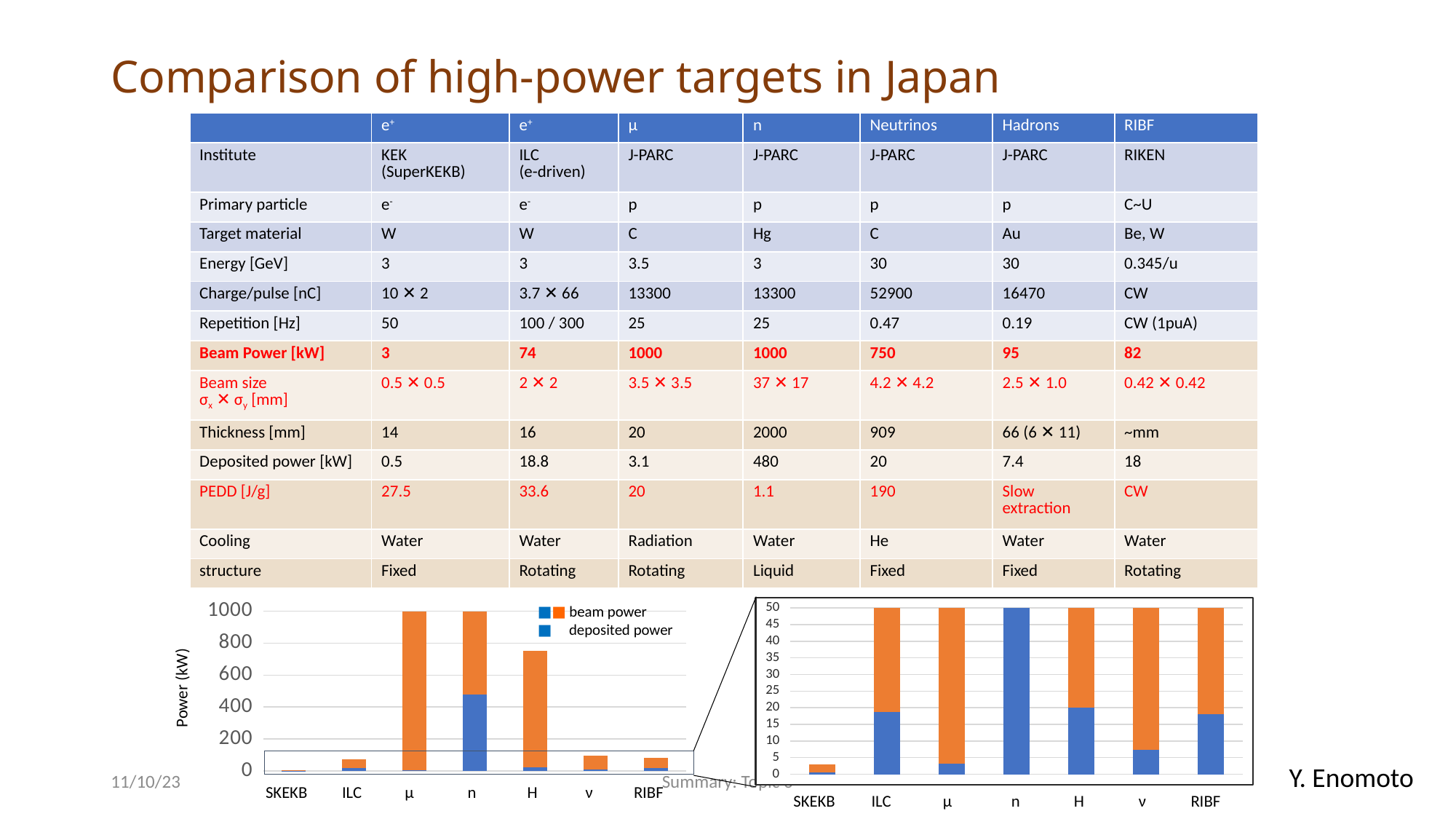
In the left chart, is the deposited power (blue) for n greater or less than 400? greater In the right (zoomed) chart, is the deposited power (blue) for ν greater or less than 10? less How many series does the legend of the left chart list? 2 What are the two legend entries of the left chart? beam power, deposited power In the left chart, which has the taller total bar, H or ν? H In the right (zoomed) chart, is the deposited power (blue) for ILC greater or less than 15? greater In the left chart, which category has the smallest total bar? SKEKB What kind of chart is the left chart at the bottom of the slide? bar chart In the left chart, which category has the largest deposited power (blue) segment? n What is the y-axis label of the left chart? Power (kW) How many categories are shown on the x axis of the left chart? 7 In the left chart, what value does the top of the μ bar reach on the y axis? 1000